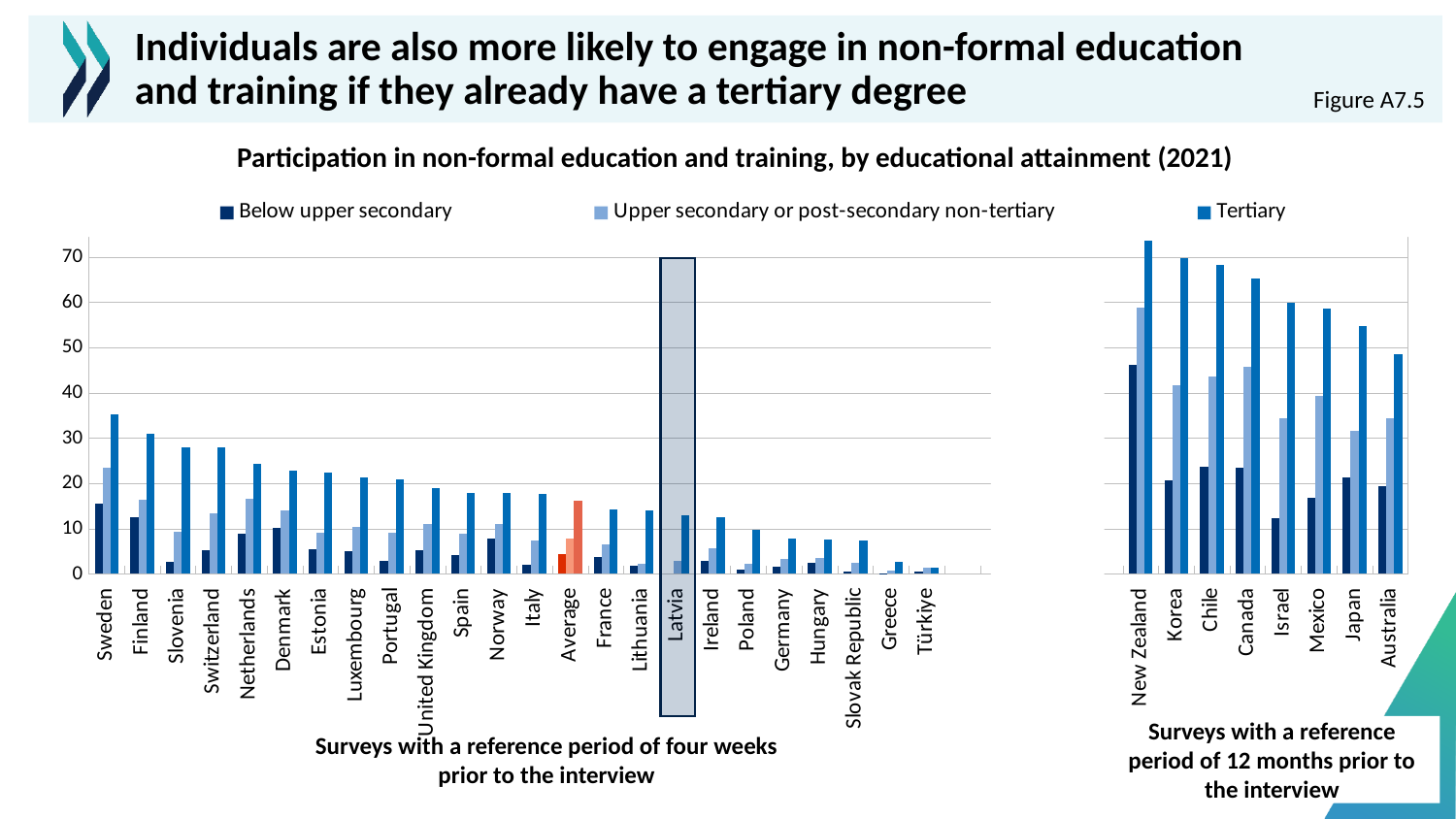
In the right-hand panel (12-month reference period), which country has the highest Tertiary value? New Zealand How many countries are shown in the right-hand panel (surveys with a reference period of 12 months prior to the interview)? 8 Is the Tertiary value for Australia greater or less than 50? less Which is larger, the Below upper secondary value for Korea or for Israel? Korea In the left-hand panel (four-week reference period), do the Tertiary values generally rise or fall from left to right? fall Is the Tertiary value for New Zealand greater or less than 70? greater Which country is highlighted with a box in the left-hand panel? Latvia In the left-hand panel (four-week reference period), which country has the highest Tertiary value? Sweden How many series does the legend list? 3 Is the Below upper secondary value for New Zealand greater or less than 40? greater What kind of chart is shown on the slide? Bar chart